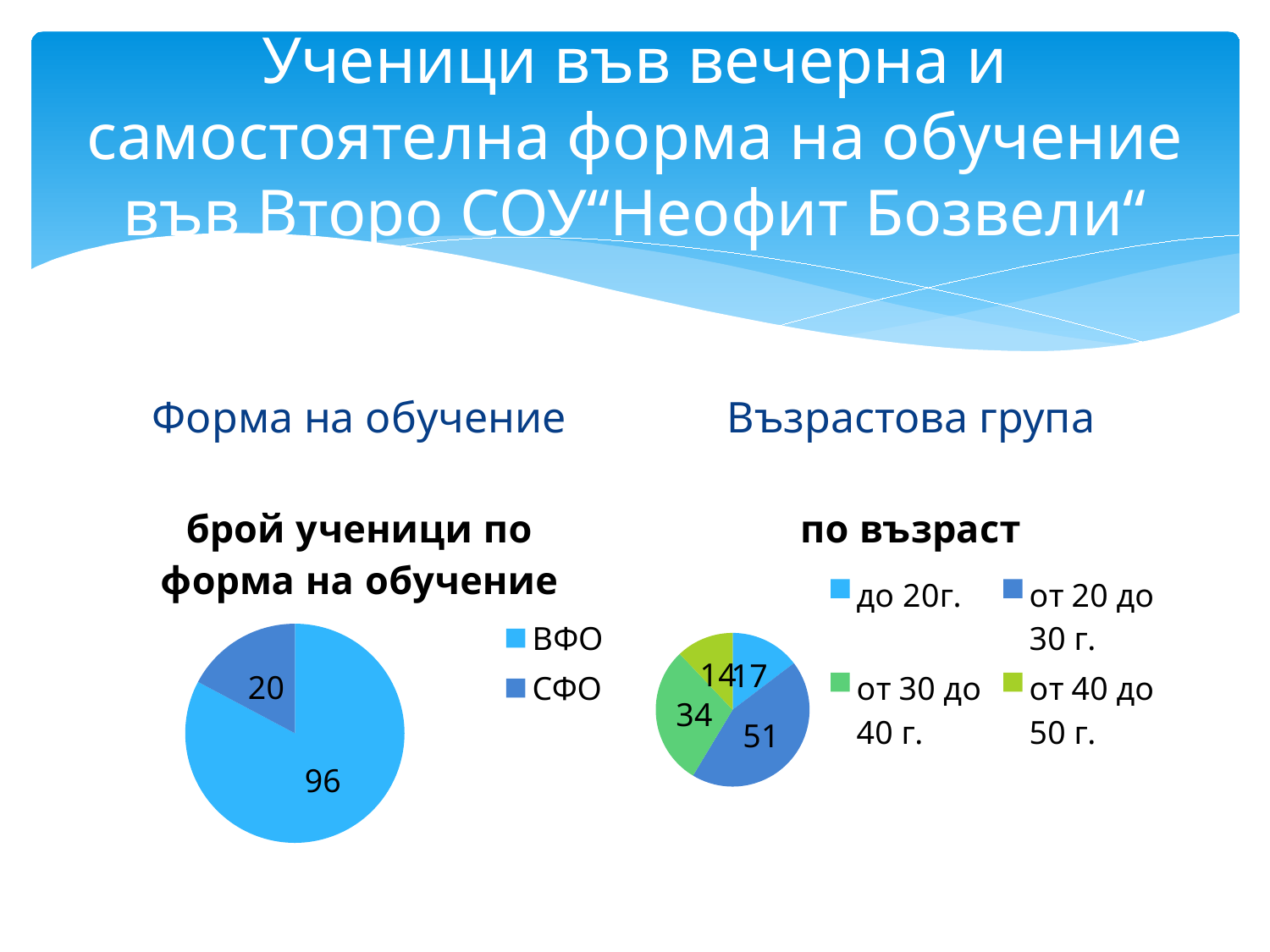
In the chart titled "по възраст", how many categories are shown? 4 In the chart titled "брой ученици по форма на обучение", how many entries does the legend list? 2 In the chart titled "по възраст", which age group has the smallest slice? от 40 до 50 г. In the chart titled "по възраст", what is the value for "от 20 до 30 г."? 51 In the chart titled "по възраст", which age group has the largest slice? от 20 до 30 г. In the chart titled "брой ученици по форма на обучение", what is the value for СФО? 20 In the chart titled "по възраст", what is the difference between the values for "от 20 до 30 г." and "от 30 до 40 г."? 17 In the chart titled "брой ученици по форма на обучение", what is the value for ВФО? 96 In the chart titled "брой ученици по форма на обучение", what kind of chart is shown? pie chart In the chart titled "брой ученици по форма на обучение", what is the difference between the ВФО and СФО values? 76 In the chart titled "по възраст", which is larger: the value for "до 20г." or the value for "от 30 до 40 г."? от 30 до 40 г. In the chart titled "по възраст", what is the value for "от 30 до 40 г."? 34